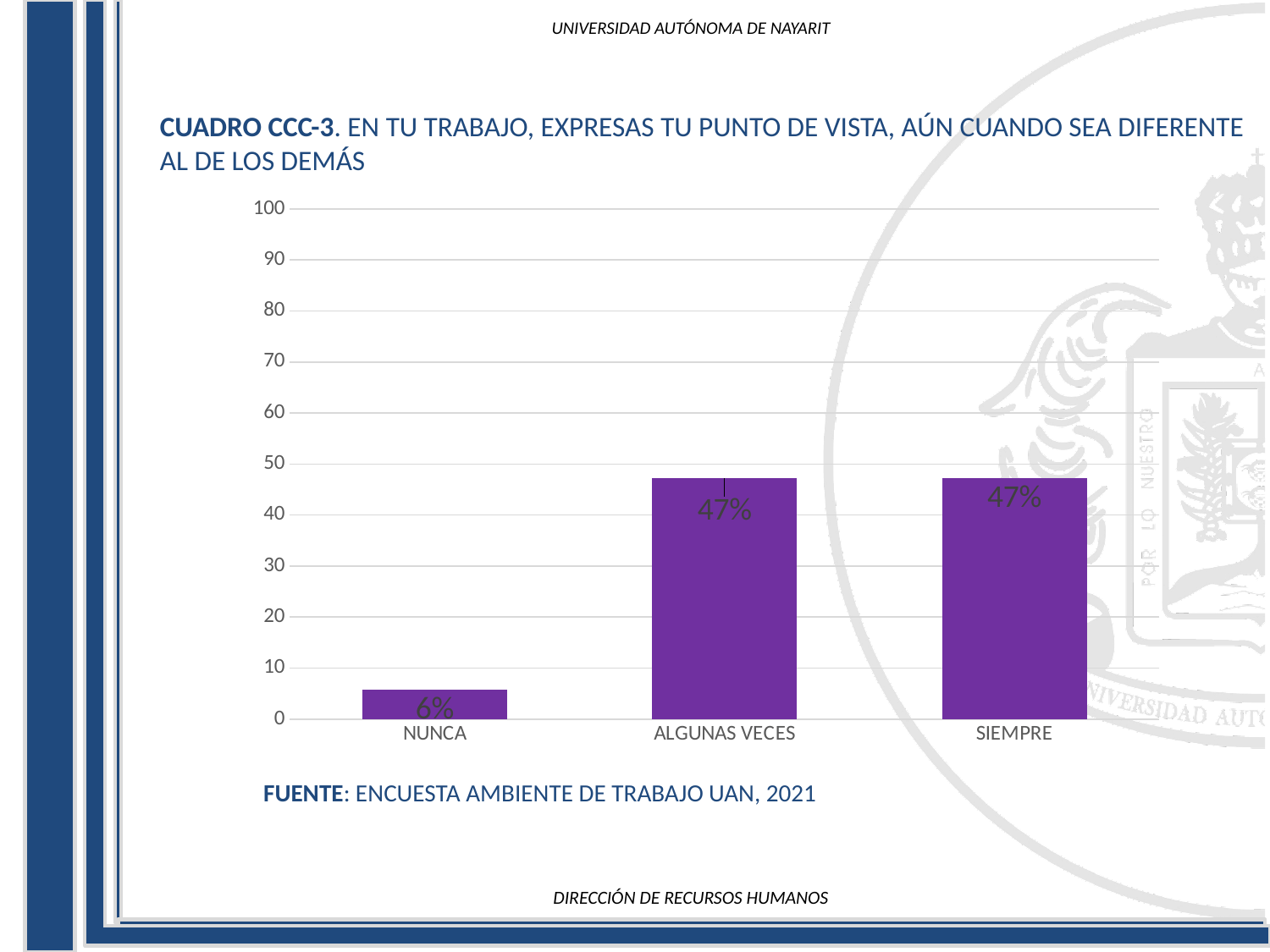
What is the source cited below the chart? ENCUESTA AMBIENTE DE TRABAJO UAN, 2021 What is the value for NUNCA? 6% Which category has the lowest value? NUNCA What is the highest value shown on the y axis? 100 Is the value for ALGUNAS VECES greater or less than 40? greater What is the value for SIEMPRE? 47% How many categories are shown on the x axis? 3 What is the value for ALGUNAS VECES? 47% What is the difference between the values for ALGUNAS VECES and NUNCA? 41% What kind of chart is shown on the slide? bar chart Is the value for NUNCA greater or less than 10? less Which is larger, the value for SIEMPRE or the value for NUNCA? SIEMPRE